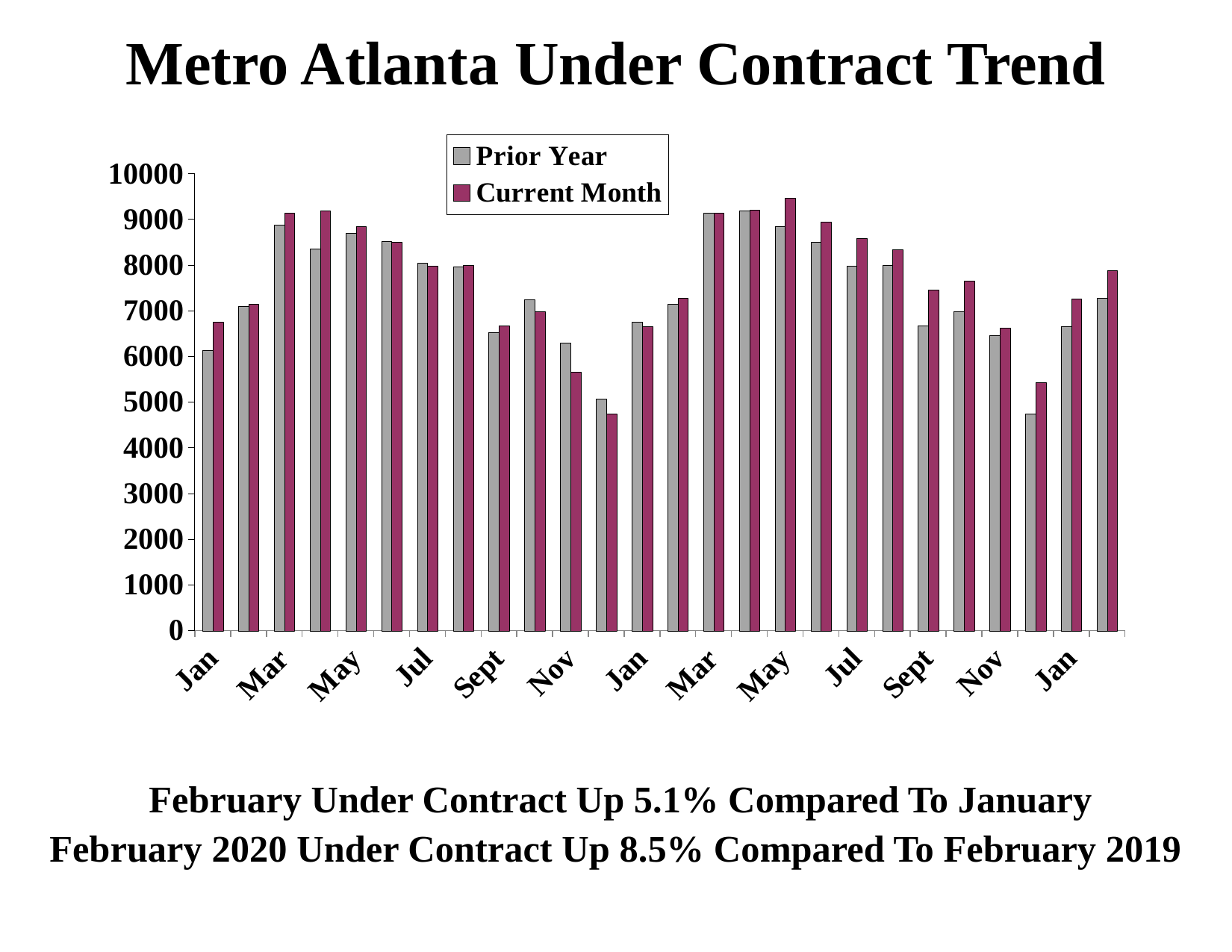
Is the Prior Year value for the first Nov on the x axis greater or less than 7000? less How many series does the legend list? 2 Is the Current Month value for the last Jan on the x axis greater or less than 7000? greater Is the Current Month value for the first Jan on the x axis greater or less than 6000? greater For the first Nov on the x axis, which is larger: the Prior Year bar or the Current Month bar? Prior Year What kind of chart is shown on the slide? bar chart Which series is drawn in the dark red/maroon colour? Current Month For the first Jan on the x axis, which is larger: the Prior Year bar or the Current Month bar? Current Month What is the title of the chart? Metro Atlanta Under Contract Trend Between the first May and the first Nov on the x axis, do the Current Month values generally rise or fall? fall At which x-axis label does the Current Month series reach its highest value? the second May